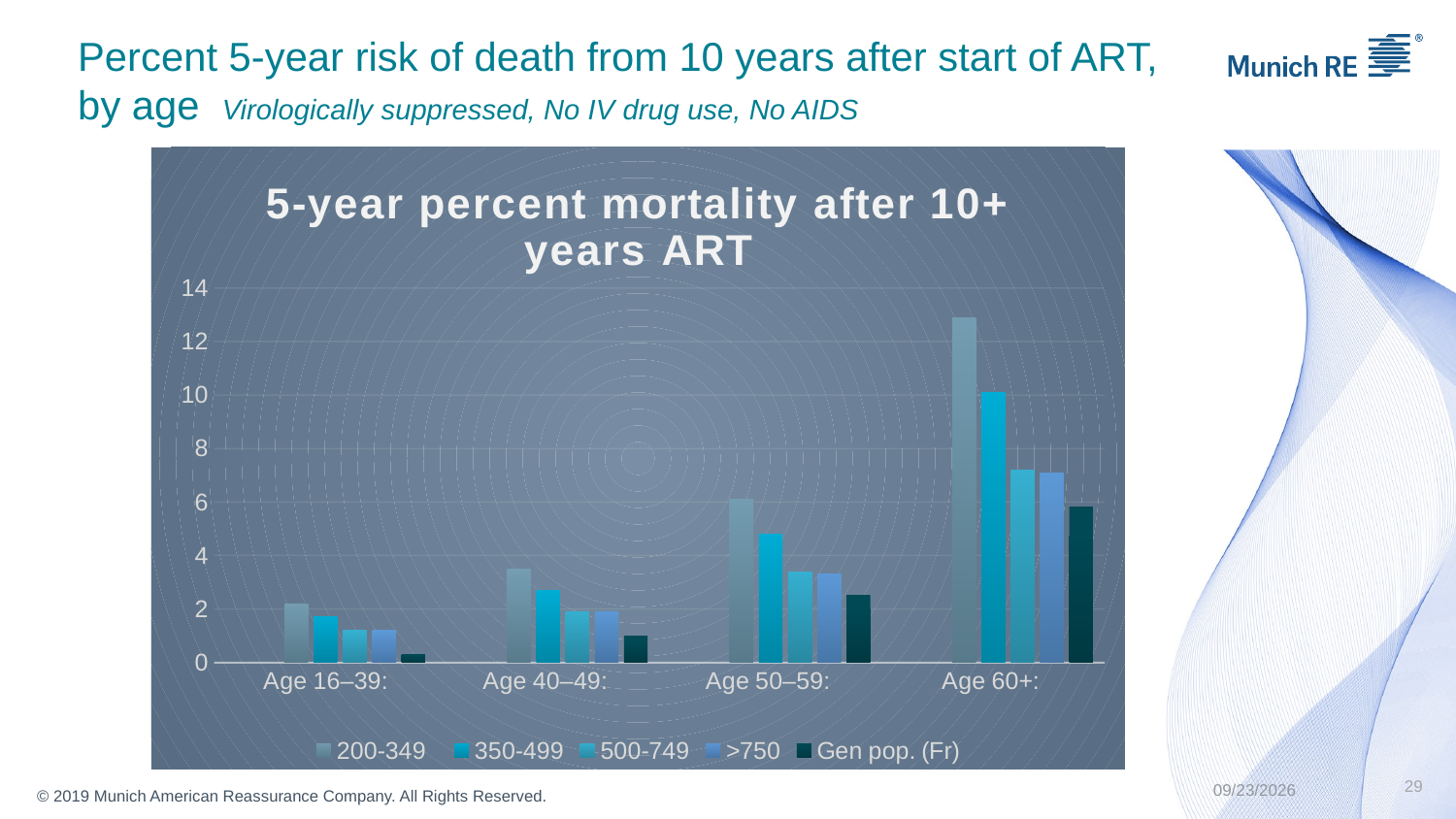
For the 200-349 series, which is larger: the value for Age 40–49 or the value for Age 50–59? Age 50–59 Which age group has the highest value for the 200-349 series? Age 60+ What is the title of the chart? 5-year percent mortality after 10+ years ART Which age group has the lowest value for the Gen pop. (Fr) series? Age 16–39 Is the value for the 200-349 series in the Age 60+ group greater or less than 12? greater Is the value for the 350-499 series in the Age 60+ group greater or less than 8? greater How many age groups are shown on the x axis of the chart? 4 Is the value for the Gen pop. (Fr) series in the Age 50–59 group greater or less than 4? less What kind of chart is shown on the slide? bar chart Do the values for the 200-349 series rise or fall as age increases along the x axis? rise How many series does the chart's legend list? 5